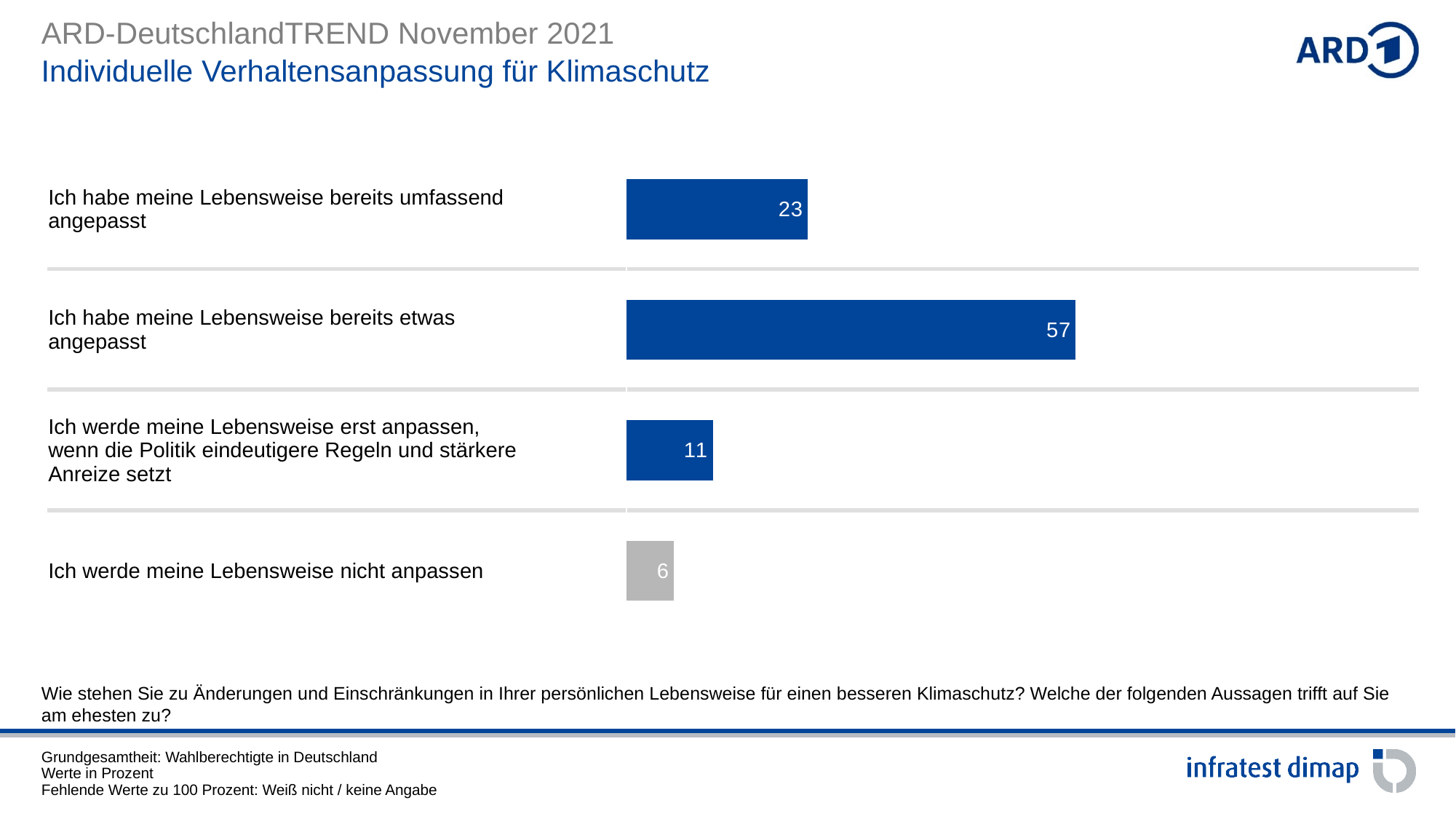
How many statements (categories) are shown in the chart? 4 What is the difference between the values for "erst anpassen, wenn die Politik eindeutigere Regeln und stärkere Anreize setzt" and "nicht anpassen"? 5 What is the value for "Ich habe meine Lebensweise bereits umfassend angepasst"? 23 What is the value for "Ich werde meine Lebensweise nicht anpassen"? 6 Which bar is shown in grey rather than blue? Ich werde meine Lebensweise nicht anpassen What is the value for "Ich werde meine Lebensweise erst anpassen, wenn die Politik eindeutigere Regeln und stärkere Anreize setzt"? 11 Which is larger: the value for "bereits umfassend angepasst" or the value for "erst anpassen, wenn die Politik eindeutigere Regeln und stärkere Anreize setzt"? Ich habe meine Lebensweise bereits umfassend angepasst What is the difference between the values for "bereits etwas angepasst" and "bereits umfassend angepasst"? 34 Which statement has the lowest value? Ich werde meine Lebensweise nicht anpassen What is the value for "Ich habe meine Lebensweise bereits etwas angepasst"? 57 What kind of chart is shown on the slide? Bar chart Which statement has the highest value? Ich habe meine Lebensweise bereits etwas angepasst